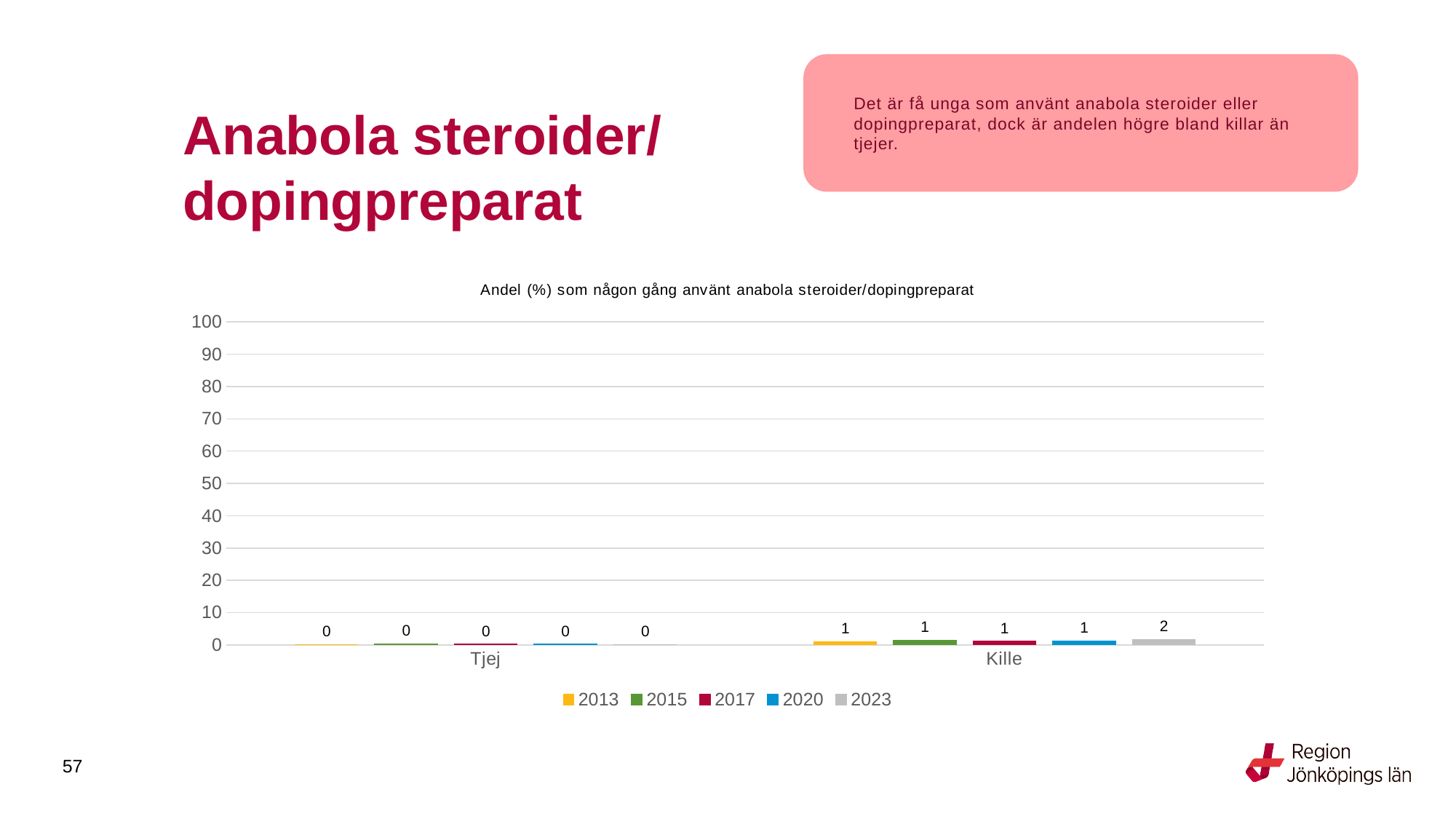
Which colour represents the 2017 series in the legend? dark red What is the title of the chart? Andel (%) som någon gång använt anabola steroider/dopingpreparat What is the difference between the Kille and Tjej values in 2023? 2 Which is larger, the value for Kille in 2020 or the value for Tjej in 2020? Kille What kind of chart is shown? bar chart What is the value for Kille in 2023? 2 How many categories are shown on the x axis? 2 How many series does the legend list? 5 What is the value for Tjej in 2017? 0 Is the value for Kille in 2023 greater or less than 10? less Which year has the highest value for Kille? 2023 What is the value for Kille in 2013? 1